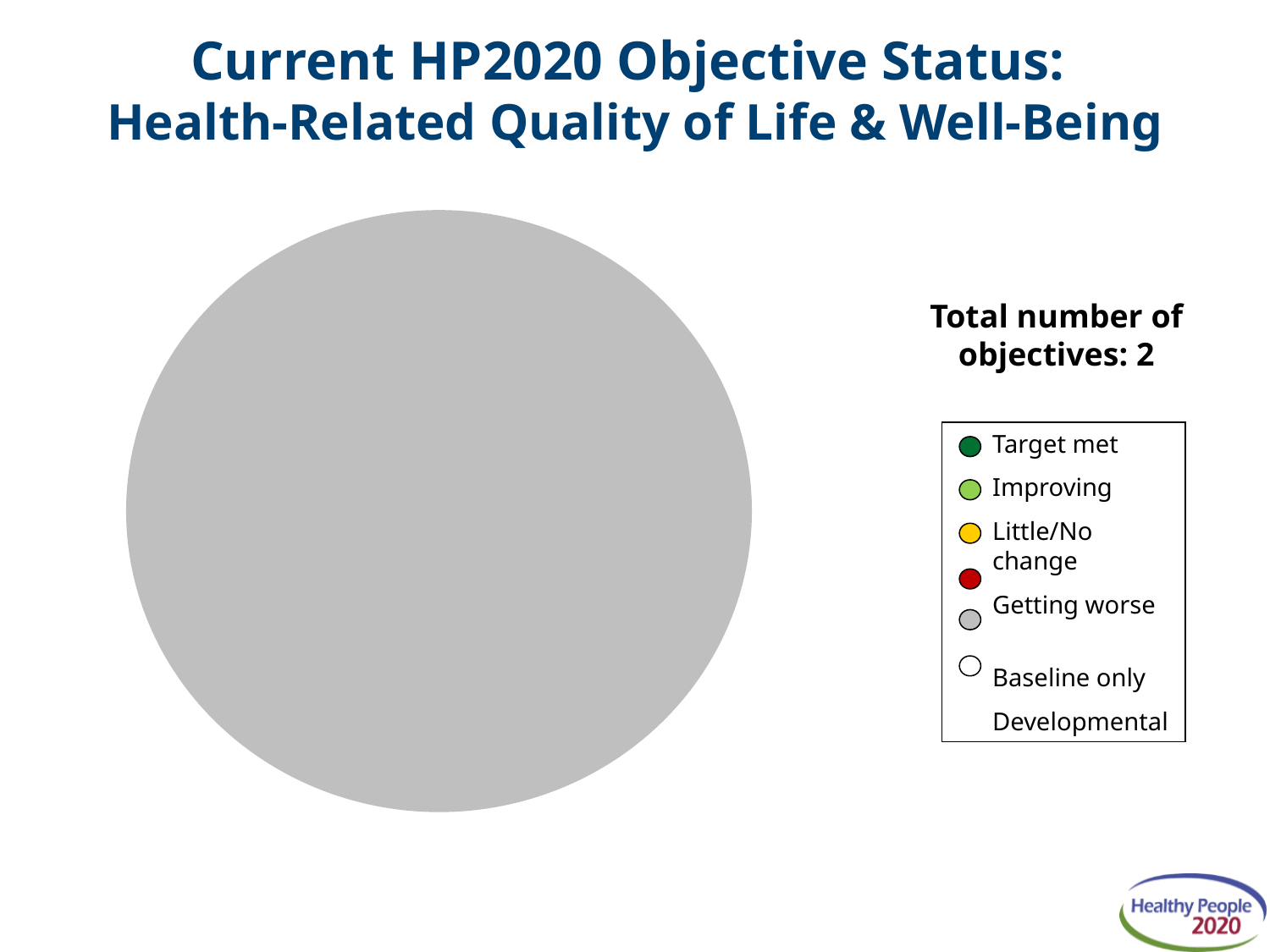
Which legend category is the entire pie chart made up of? Baseline only What is the title of the slide containing the chart? Current HP2020 Objective Status: Health-Related Quality of Life & Well-Being What kind of chart is shown on the slide? pie chart What is the total number of objectives stated on the slide? 2 What share of the pie is taken up by the gray slice? 100% How many slices does the pie chart contain? 1 Which status category does the gray colour in the legend represent? Baseline only How many entries does the legend list? 6